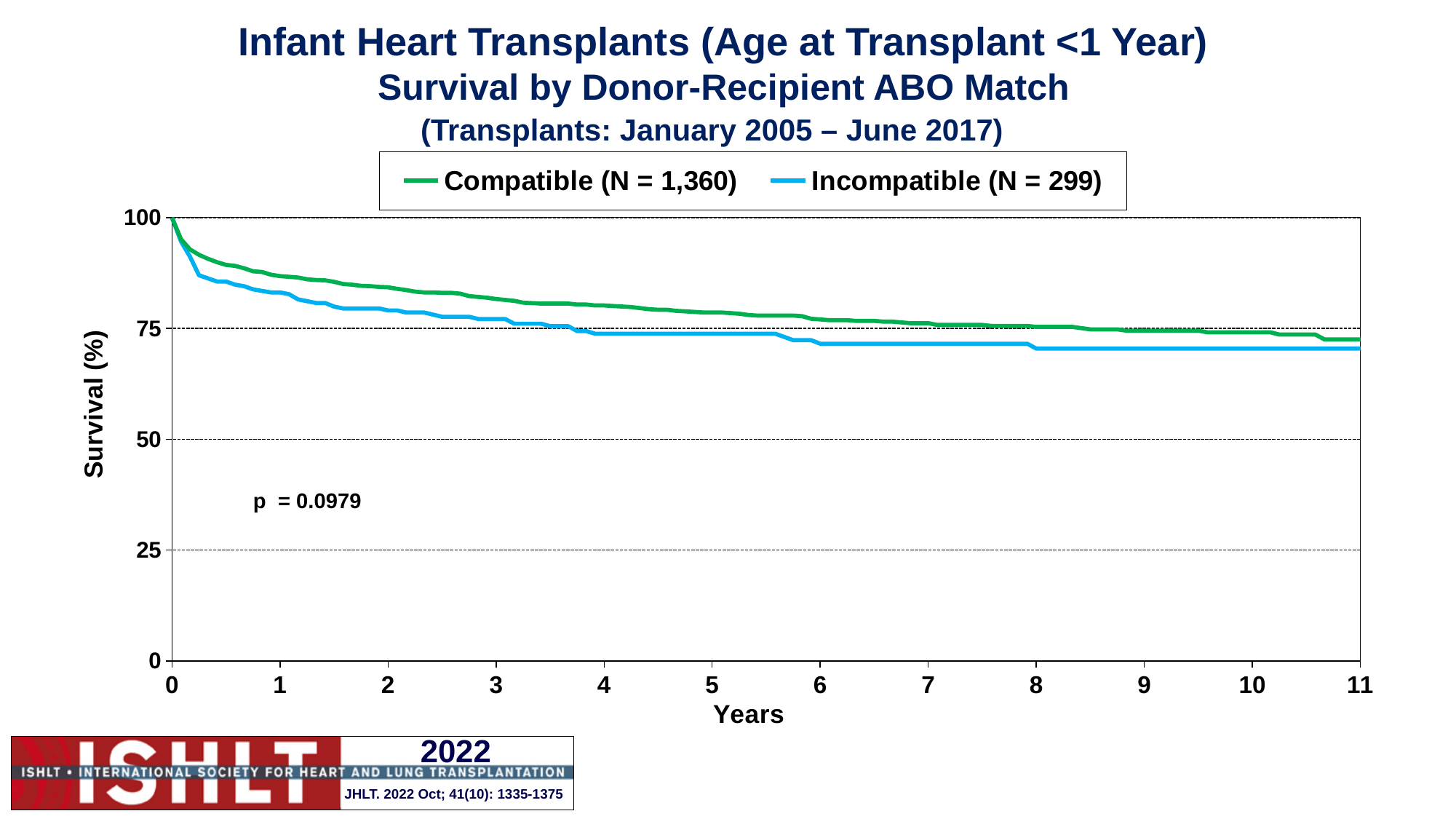
Is the survival value for the Compatible group at 2 years greater or less than 75? greater What is the maximum value shown on the x axis? 11 At 5 years, which group has higher survival, Compatible or Incompatible? Compatible Is the survival value for the Incompatible group at 10 years greater or less than 75? less How many series does the legend list? 2 What is the sample size (N) for the Incompatible group shown in the legend? 299 What is the label of the x axis? Years Does survival rise or fall along the x axis for the Compatible group? Fall What kind of chart is shown on the slide? Line chart What is the sample size (N) for the Compatible group shown in the legend? 1,360 Which colour represents the Incompatible group? Blue What p-value is printed on the chart? p = 0.0979